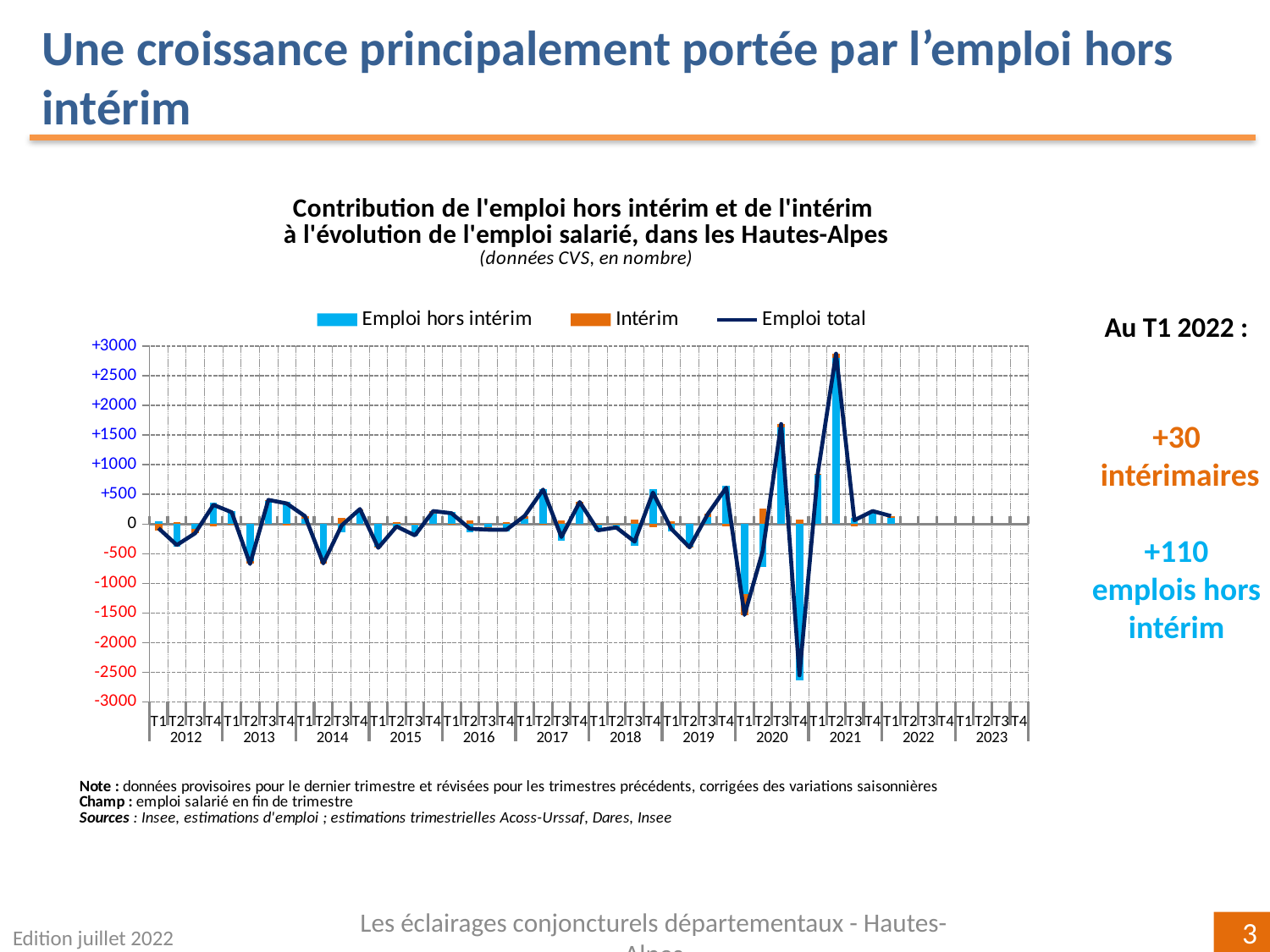
Which is larger, the 'Emploi total' value for T2 2021 or for T3 2020? T2 2021 According to the annotation, what is the contribution of 'emplois hors intérim' at T1 2022? +110 In which quarter does the 'Emploi total' line reach its highest value? T2 2021 Which colour represents the 'Intérim' series? Orange How many series does the legend list? 3 In which quarter does the 'Emploi total' line reach its lowest value? T4 2020 Is the 'Emploi hors intérim' value for T3 2020 greater or less than +1000? greater What kind of chart is shown on the slide? A combined bar and line chart Which series is drawn as a line rather than bars? Emploi total How many years are labelled along the x axis? 12 Is the 'Emploi total' value for T2 2021 greater or less than +2500? greater